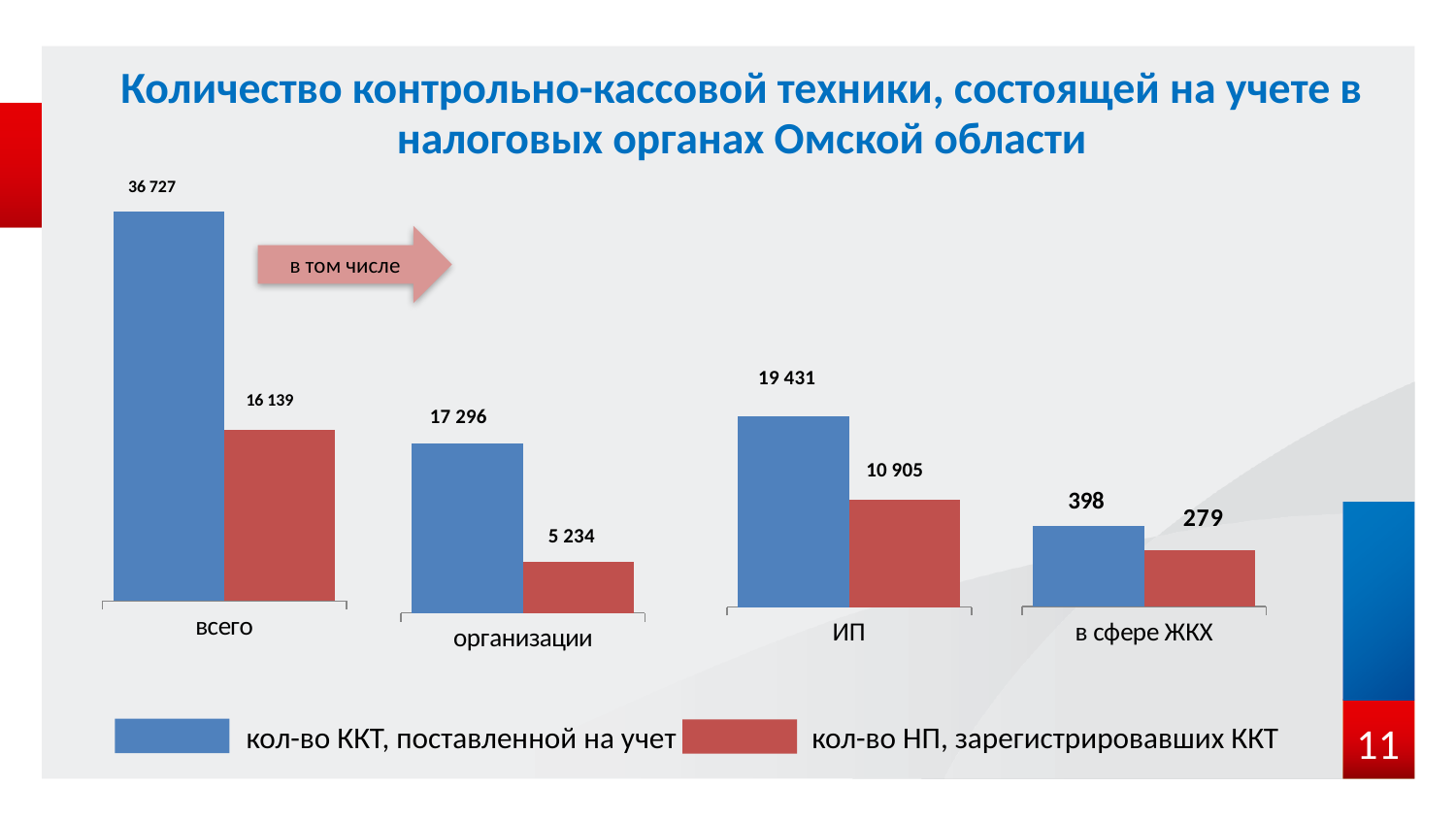
Which category has the highest value of 'кол-во НП, зарегистрировавших ККТ'? всего How many series does the legend list? 2 What is the difference between 'кол-во ККТ, поставленной на учет' and 'кол-во НП, зарегистрировавших ККТ' for the category 'ИП'? 8 526 What type of chart is shown on the slide? bar chart What is the value of 'кол-во ККТ, поставленной на учет' for the category 'всего'? 36 727 What is the value of 'кол-во НП, зарегистрировавших ККТ' for the category 'организации'? 5 234 How many categories are shown on the chart? 4 What is the value of 'кол-во ККТ, поставленной на учет' for the category 'ИП'? 19 431 What is the value of 'кол-во НП, зарегистрировавших ККТ' for the category 'в сфере ЖКХ'? 279 Which category has the lowest value of 'кол-во ККТ, поставленной на учет'? в сфере ЖКХ What colour represents the series 'кол-во НП, зарегистрировавших ККТ'? red Which is larger: 'кол-во ККТ, поставленной на учет' for 'организации' or for 'ИП'? ИП